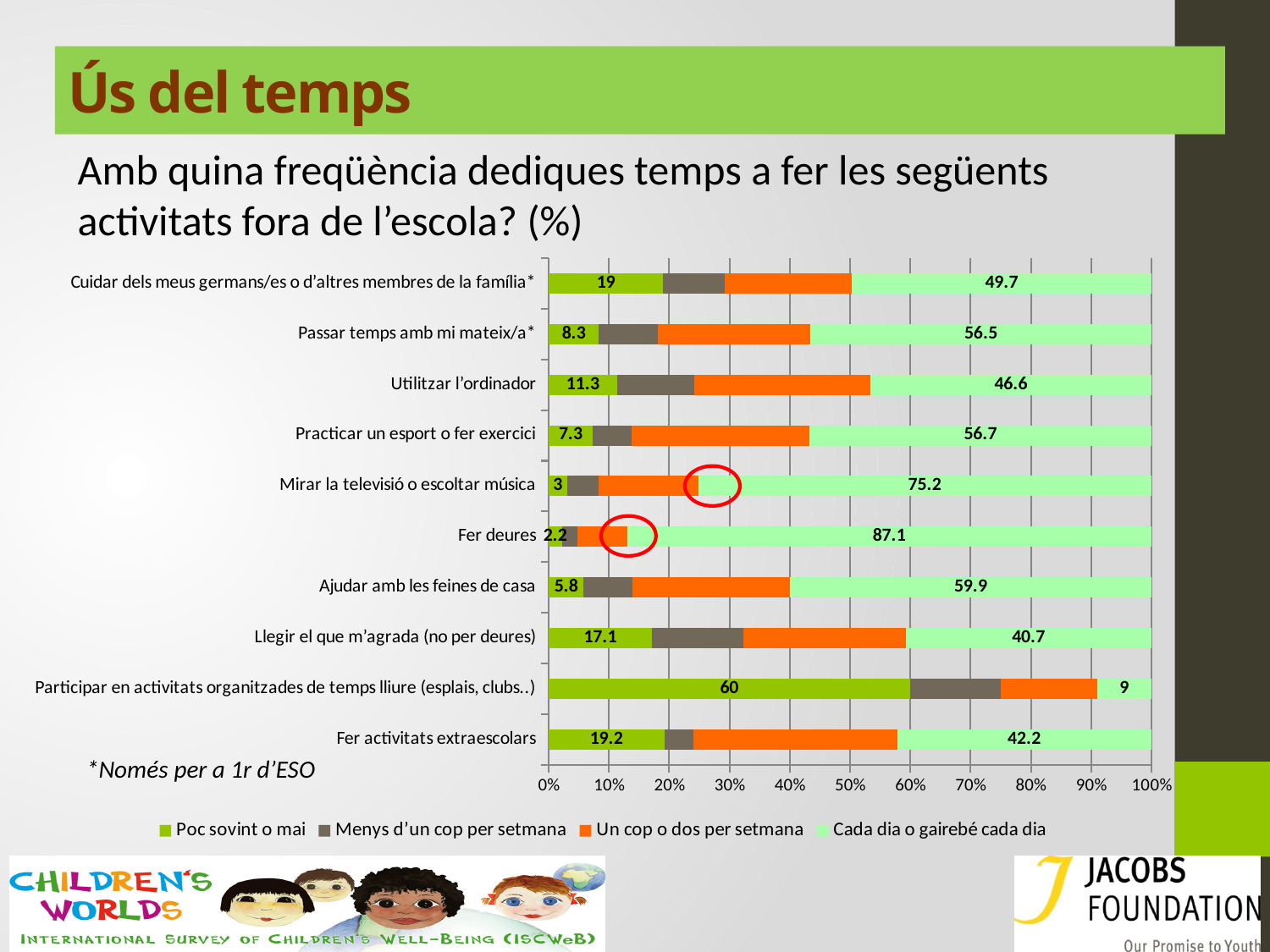
Which activity has the highest "Cada dia o gairebé cada dia" value? Fer deures How many activities are shown in the chart? 10 How many series does the legend list? 4 Which activity has the lowest "Cada dia o gairebé cada dia" value? Participar en activitats organitzades de temps lliure (esplais, clubs..) What percentage of respondents answered "Cada dia o gairebé cada dia" for "Fer deures"? 87.1 What is the "Poc sovint o mai" value for "Participar en activitats organitzades de temps lliure (esplais, clubs..)"? 60 What kind of chart is shown on the slide? Stacked bar chart What is the "Cada dia o gairebé cada dia" value for "Mirar la televisió o escoltar música"? 75.2 Which activity has the highest "Poc sovint o mai" value? Participar en activitats organitzades de temps lliure (esplais, clubs..) What is the "Poc sovint o mai" value for "Fer activitats extraescolars"? 19.2 Which has a larger "Cada dia o gairebé cada dia" value: "Utilitzar l'ordinador" or "Fer activitats extraescolars"? Utilitzar l'ordinador What is the difference between the "Cada dia o gairebé cada dia" values for "Fer deures" and "Mirar la televisió o escoltar música"? 11.9